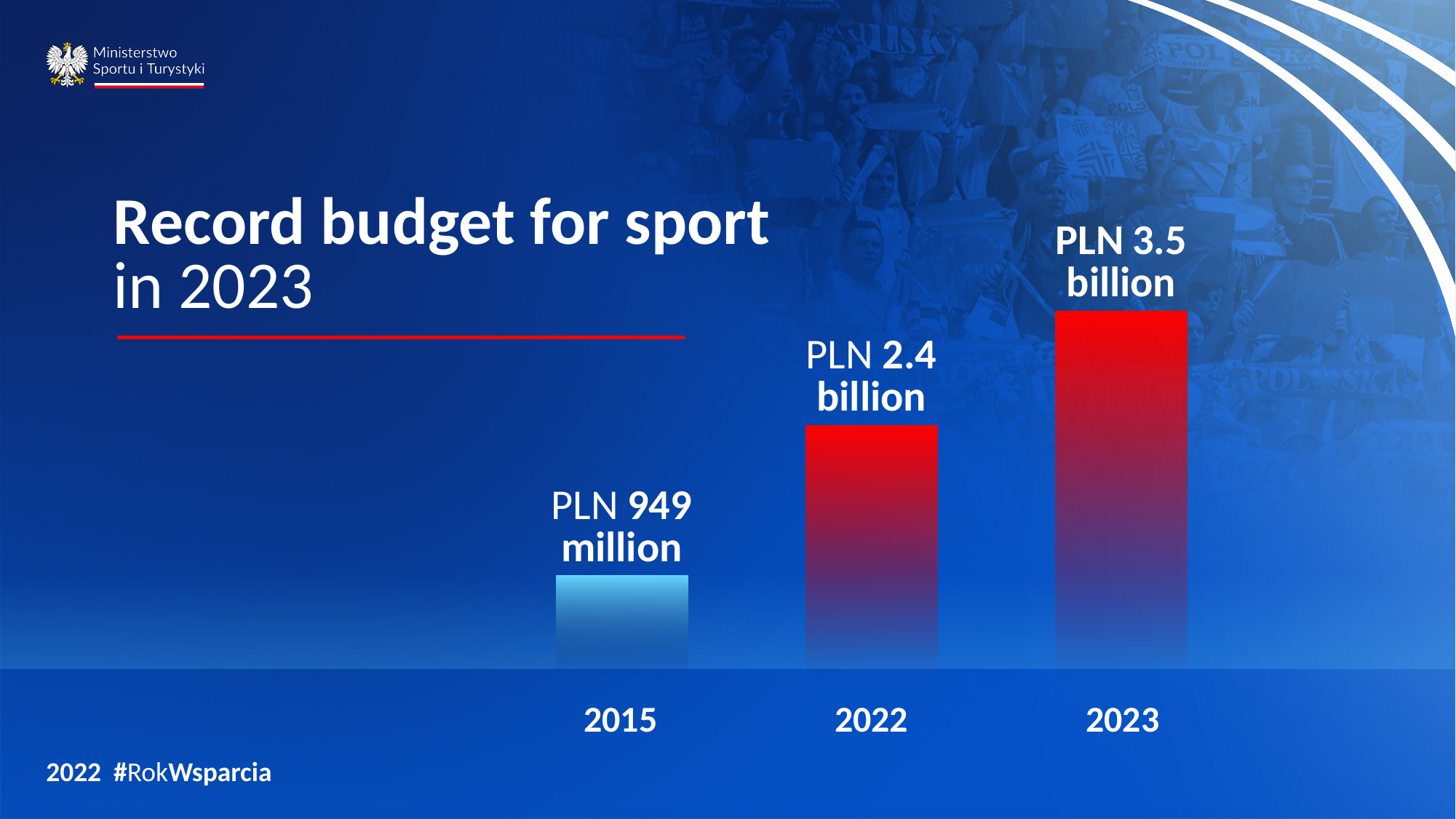
What kind of chart is shown on the slide? Bar chart What is the difference between the 2023 and 2022 budgets? PLN 1.1 billion What is the sport budget shown for 2015? PLN 949 million What is the sport budget shown for 2023? PLN 3.5 billion What is the title of the slide? Record budget for sport in 2023 Which year has the larger budget, 2015 or 2022? 2022 Which year has the lowest sport budget? 2015 How many years are shown in the chart? 3 What colour is the bar for 2015? Light blue Do the budget values rise or fall from 2015 to 2023? Rise Which year has the highest sport budget? 2023 What is the sport budget shown for 2022? PLN 2.4 billion